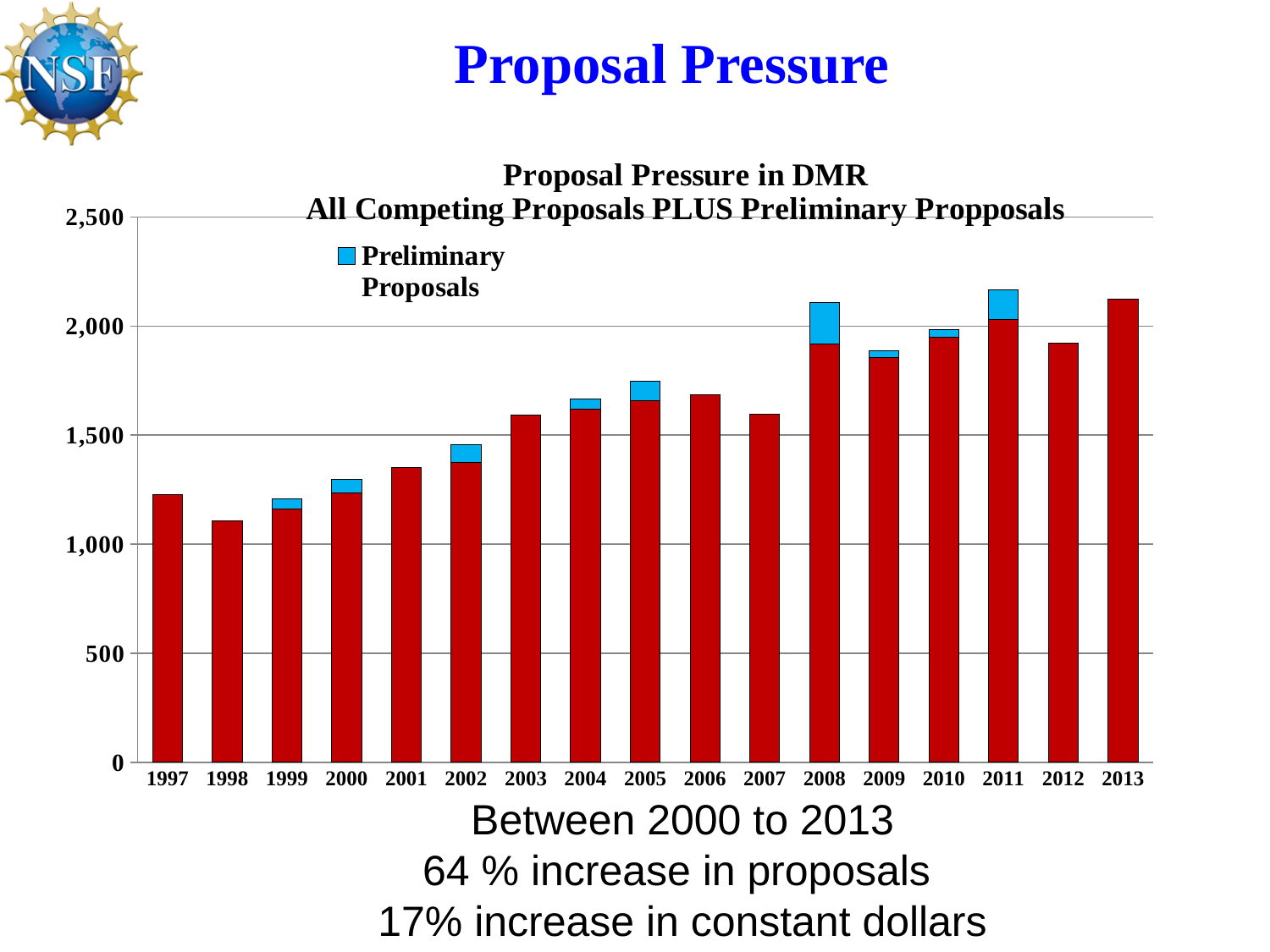
Which year has the larger total bar, 2007 or 2008? 2008 What series name does the legend of the chart show? Preliminary Proposals Is the total bar for 1998 greater or less than 1,000? greater Is the total bar for 2012 greater or less than 2,000? less Which year has the larger total bar, 1997 or 1998? 1997 Is the total bar for 2001 greater or less than 1,500? less Overall, do the bars rise or fall from 1997 to 2013? rise What kind of chart is shown on the slide? bar chart How many years are shown along the x axis of the chart? 17 How many series does the chart's legend list? 1 Which year has the lowest total bar in the chart? 1998